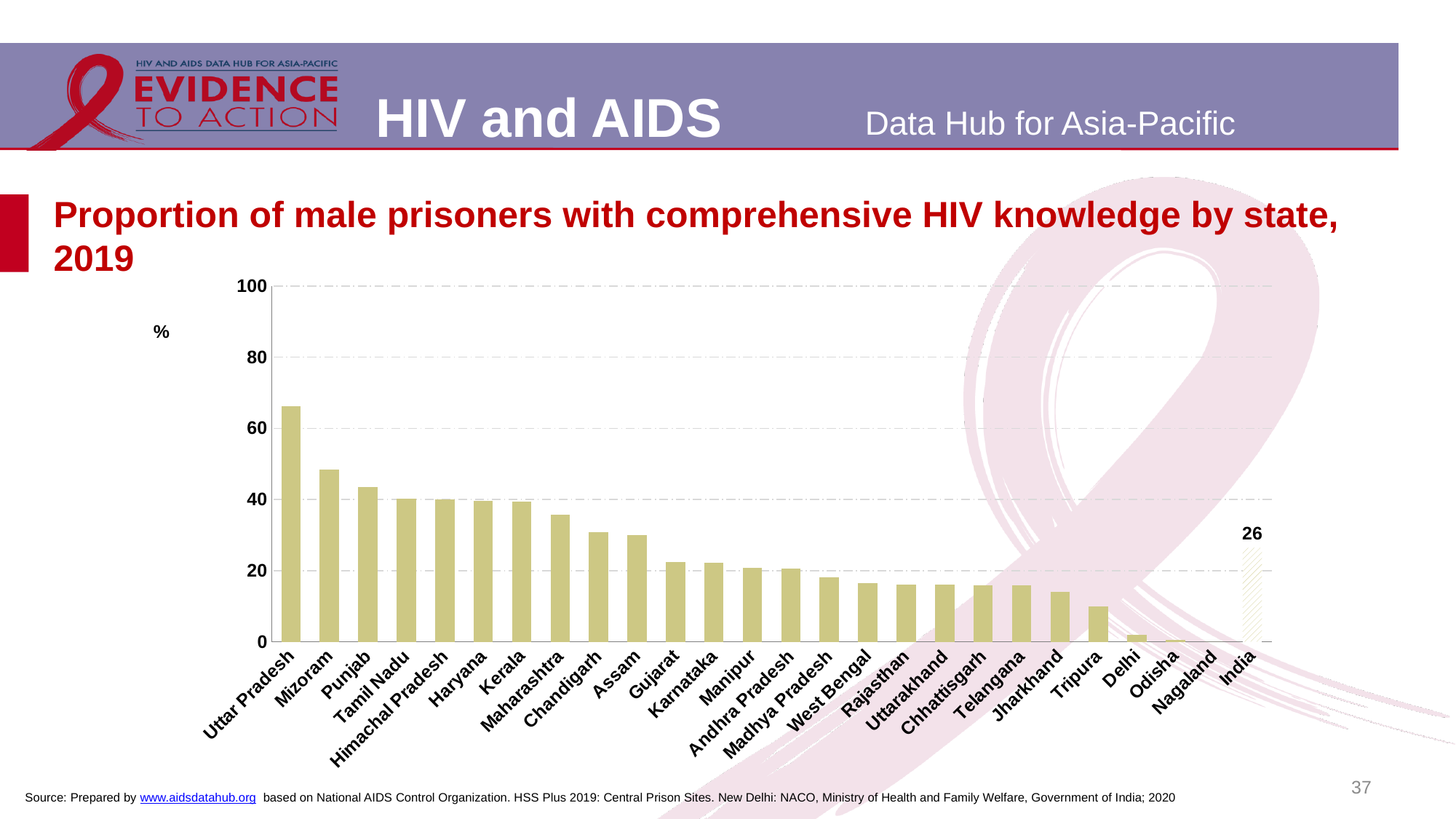
Is the value for Uttar Pradesh greater or less than 60? greater Which state has the highest proportion of male prisoners with comprehensive HIV knowledge? Uttar Pradesh Is the value for Mizoram greater or less than 40? greater Which has a higher value, Punjab or Assam? Punjab What unit is shown on the y axis of the chart? % Which has a higher value, Jharkhand or Tripura? Jharkhand Is the value for Maharashtra greater or less than 40? less How many categories are plotted along the x axis? 26 What is the value shown for India? 26 What type of chart is shown on the slide? bar chart Do the bar values generally rise or fall moving from left to right across the states? fall